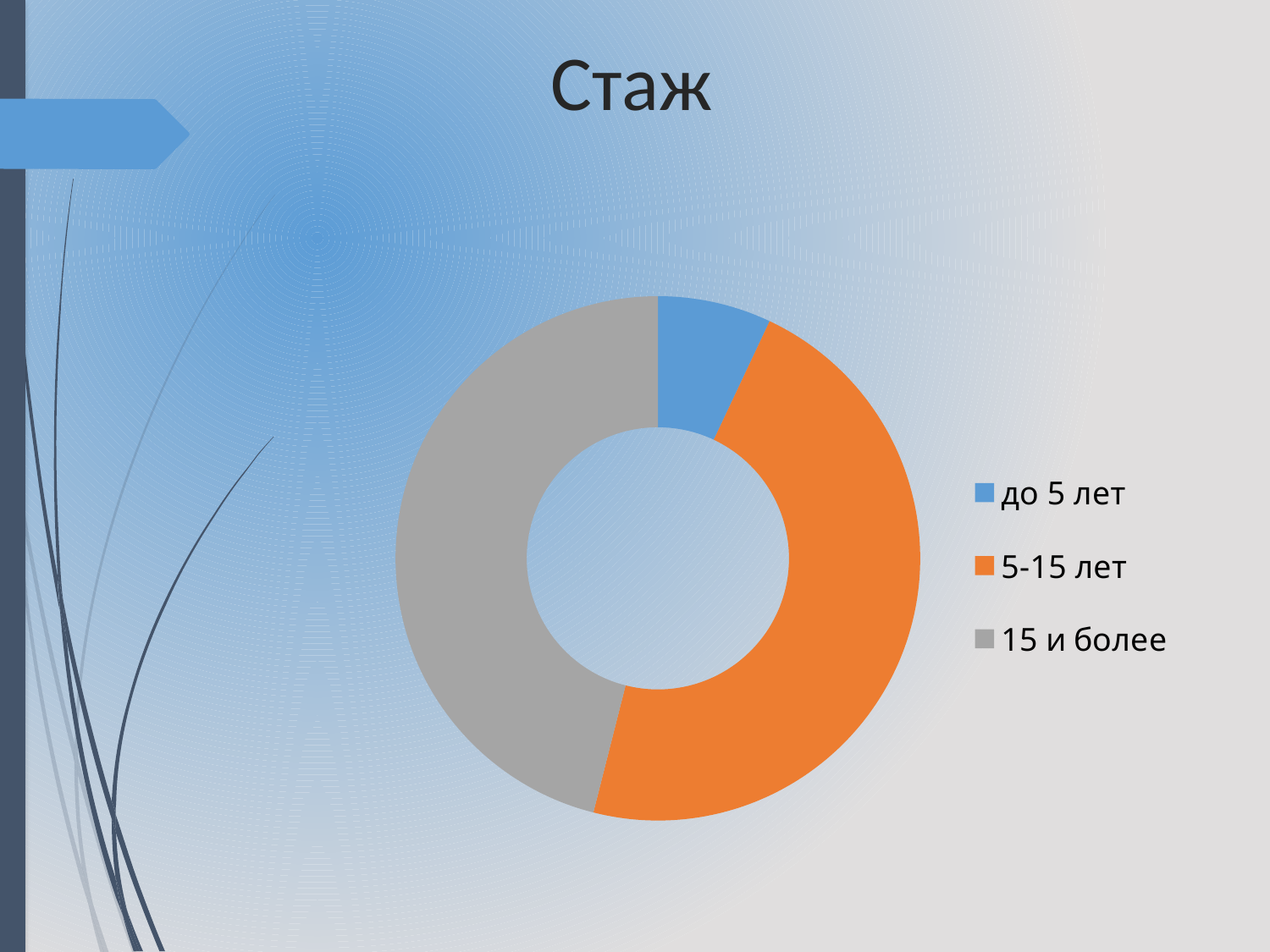
Which is larger, the share for до 5 лет or the share for 5-15 лет? 5-15 лет How many categories does the chart show? 3 How many entries does the legend list? 3 What kind of chart is shown on the slide? doughnut chart Which category has the smallest share of the chart? до 5 лет Which category is shown in grey? 15 и более Which is larger, the share for до 5 лет or the share for 15 и более? 15 и более What colour represents the category 5-15 лет? orange What is the title of the chart? Стаж